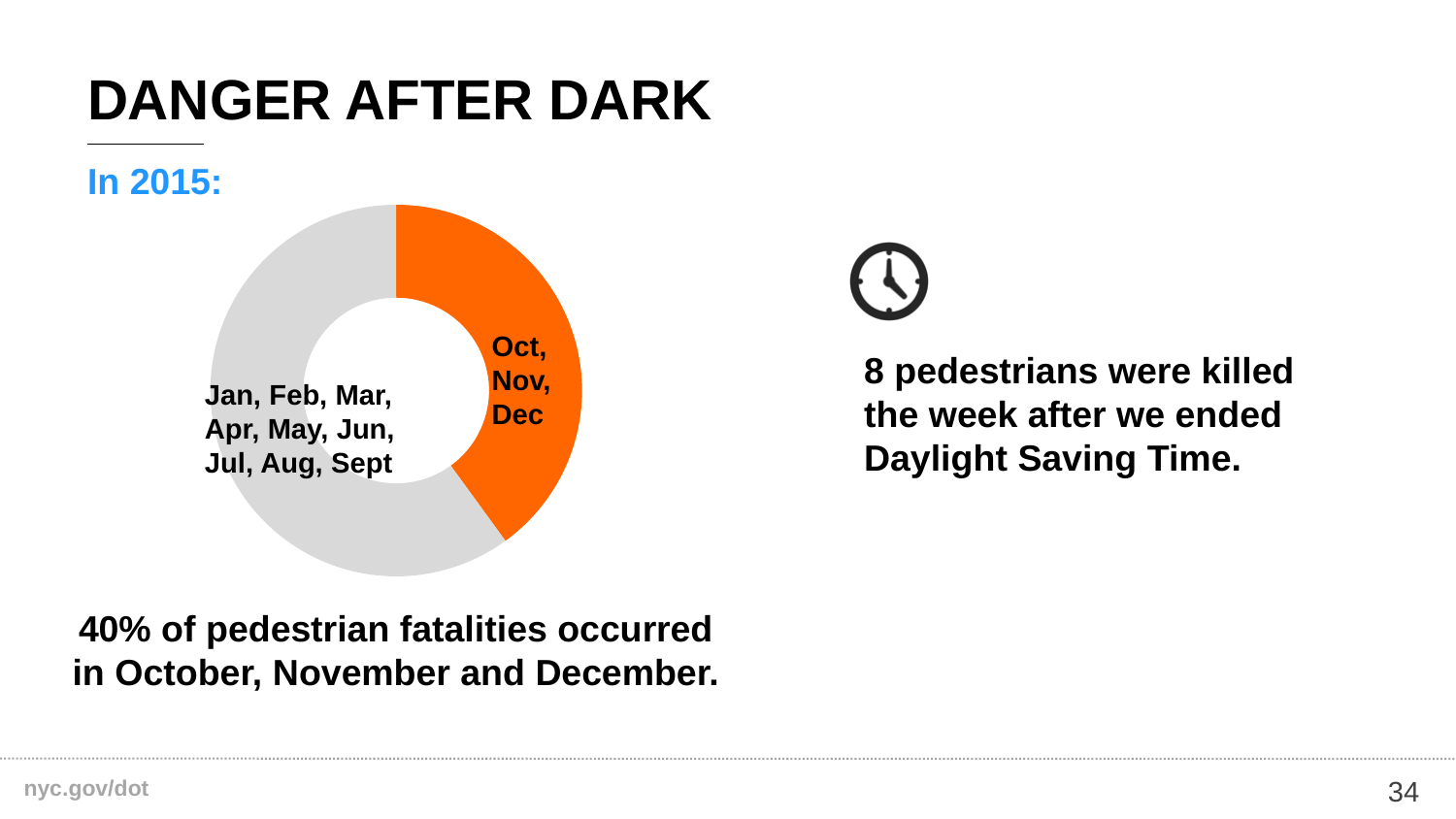
Which year does the pie chart's data refer to? 2015 Which slice is larger: Oct, Nov, Dec or Jan through Sept? Jan through Sept What share of pedestrian fatalities does the Jan, Feb, Mar, Apr, May, Jun, Jul, Aug, Sept slice represent? 60% Which slice of the pie chart is the smallest? Oct, Nov, Dec What share of pedestrian fatalities does the Oct, Nov, Dec slice represent? 40% How many slices does the pie chart have? 2 What colour is the Oct, Nov, Dec slice? orange What kind of chart is shown on the slide? pie chart (donut) Which slice of the pie chart is the largest? Jan, Feb, Mar, Apr, May, Jun, Jul, Aug, Sept